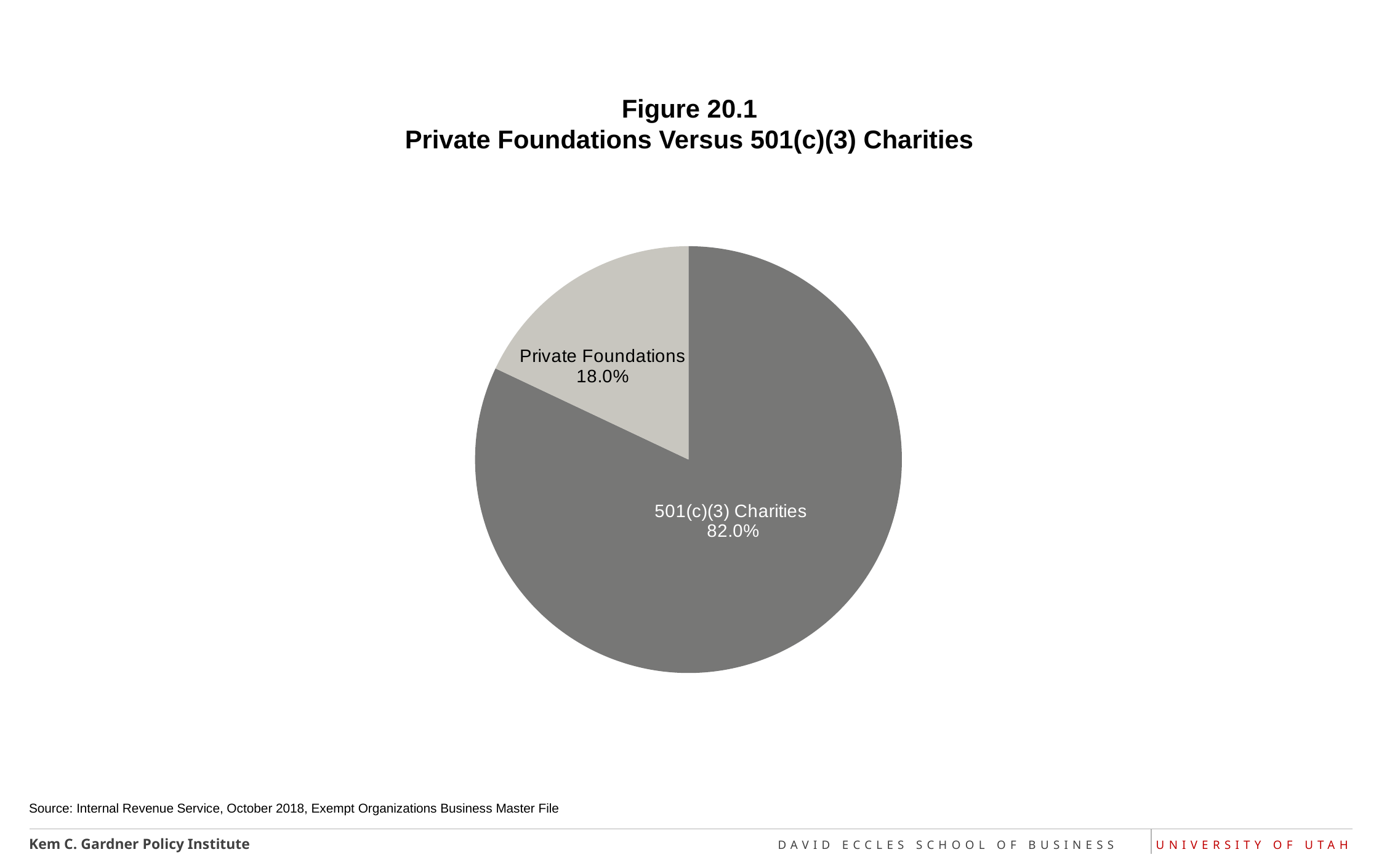
Which slice is the largest? 501(c)(3) Charities What is the title of the chart? Figure 20.1 Private Foundations Versus 501(c)(3) Charities What is the difference in percentage points between the 501(c)(3) Charities slice and the Private Foundations slice? 64.0 percentage points Which slice is shown in the darker grey colour? 501(c)(3) Charities What share of the pie is Private Foundations? 18.0% What share of the pie is 501(c)(3) Charities? 82.0% Which slice is the smallest? Private Foundations How many slices does the pie chart have? 2 Which is larger, the Private Foundations slice or the 501(c)(3) Charities slice? 501(c)(3) Charities What is the combined share of the two slices? 100.0% What kind of chart is shown on the slide? Pie chart